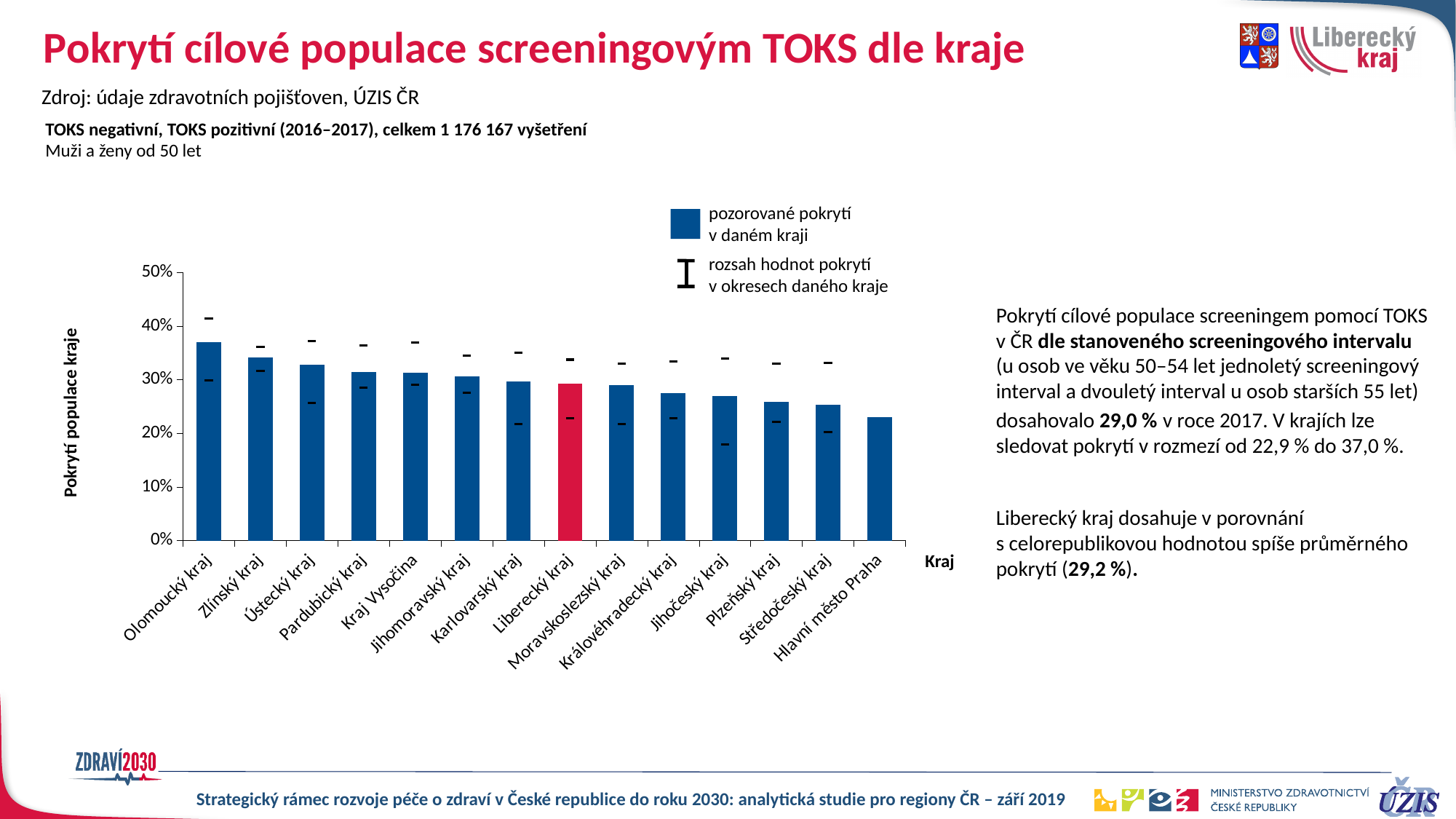
Is the value for Hlavní město Praha greater or less than 30%? less Which has a higher observed coverage, Zlínský kraj or Plzeňský kraj? Zlínský kraj Do the bar values rise or fall from left to right along the x axis? fall What kind of chart is shown on the slide? bar chart How many entries does the chart legend list? 2 Is the value for Olomoucký kraj greater or less than 30%? greater Which region's bar is highlighted in red in the chart? Liberecký kraj Which region has the highest observed coverage in the chart? Olomoucký kraj How many regions (kraje) are shown on the x axis of the chart? 14 Is the value for Středočeský kraj greater or less than 30%? less According to the slide, what is the screening coverage for Liberecký kraj? 29,2 % Which region has the lowest observed coverage in the chart? Hlavní město Praha